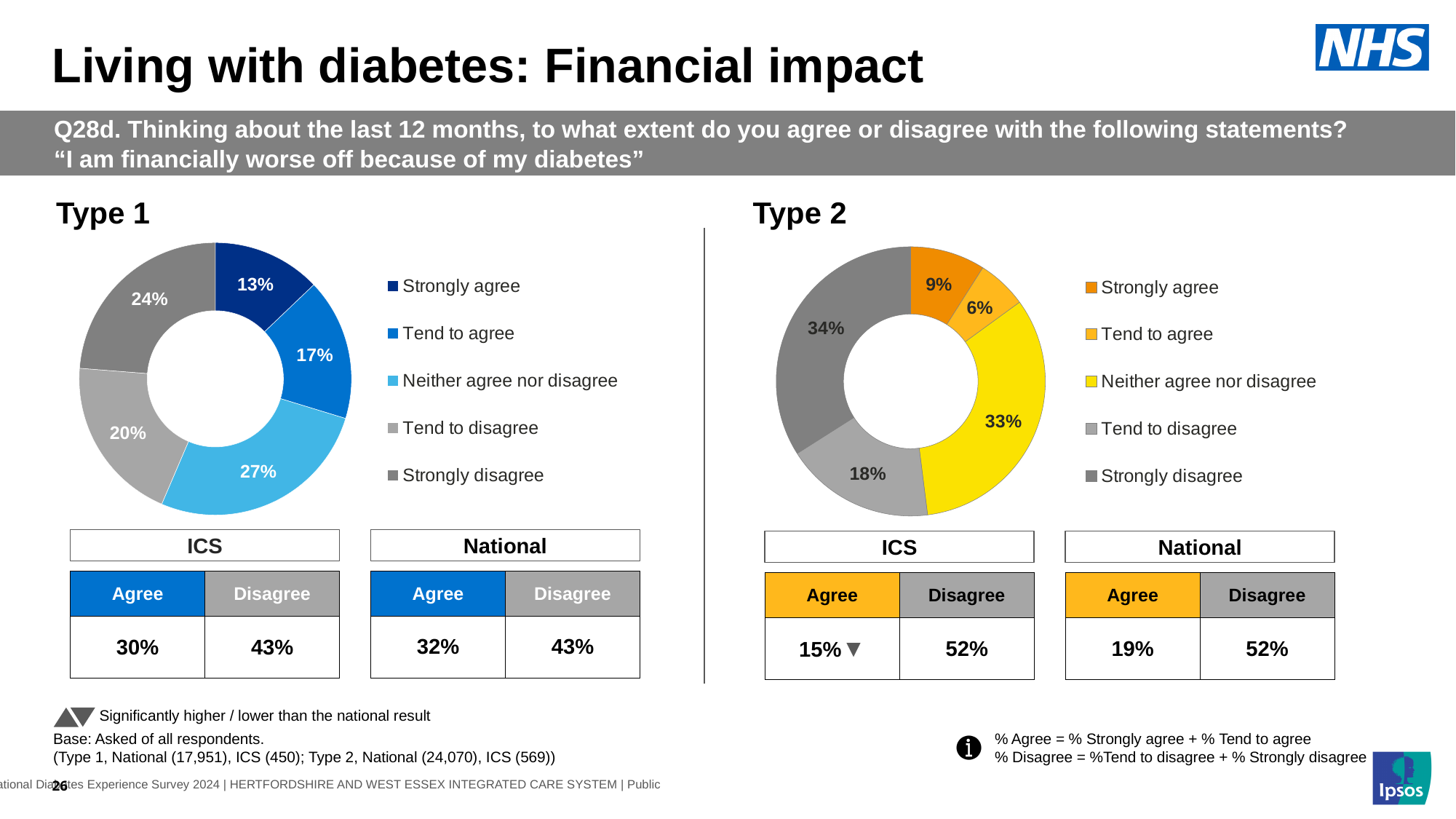
In the Type 2 chart, what colour is the Neither agree nor disagree segment? Yellow In the Type 2 chart, what percentage of respondents said they tend to agree? 6% In the Type 1 chart, which response category has the largest share? Neither agree nor disagree In the Type 2 chart, what is the difference between the Neither agree nor disagree and Strongly agree shares? 24% In the Type 2 chart, which response category has the smallest share? Tend to agree In the Type 2 chart, which is larger: the Strongly disagree share or the Tend to disagree share? Strongly disagree In the Type 1 chart, what is the difference between the Strongly disagree and Tend to disagree shares? 4% What kind of chart is used for Type 2? Donut (pie) chart How many response categories does the Type 1 chart's legend list? 5 In the Type 1 chart, what percentage of respondents said they strongly agree? 13% In the Type 2 chart, what percentage of respondents said they strongly disagree? 34% In the Type 1 chart, what percentage of respondents said they neither agree nor disagree? 27%